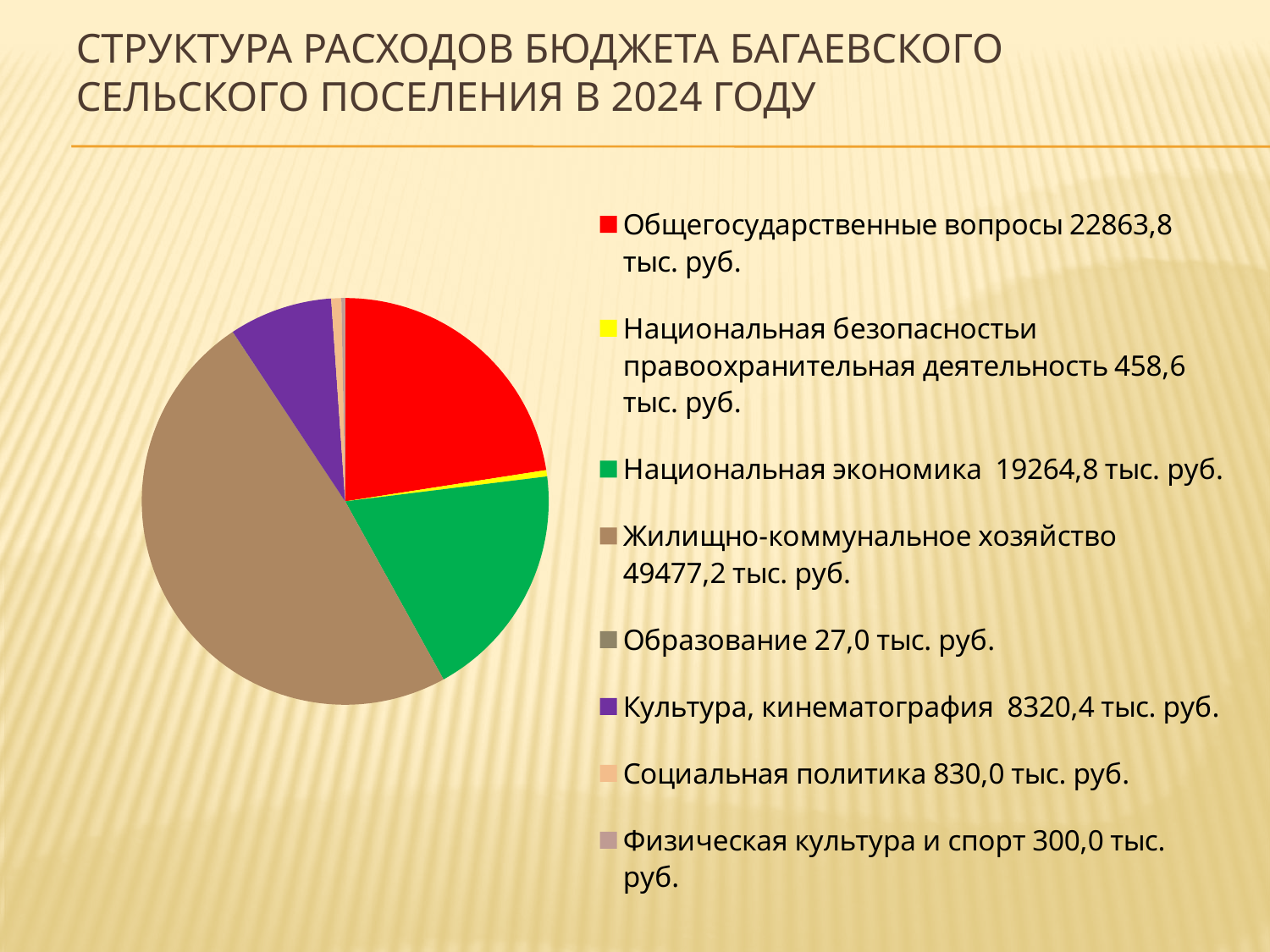
Which category has the largest share of the pie? Жилищно-коммунальное хозяйство What is the difference between Жилищно-коммунальное хозяйство and Общегосударственные вопросы? 26613,4 тыс. руб. Which is larger, Общегосударственные вопросы or Национальная экономика? Общегосударственные вопросы What is the value for Культура, кинематография? 8320,4 тыс. руб. What is the value for Национальная экономика? 19264,8 тыс. руб. Which category has the smallest value? Образование How many categories does the pie chart have? 8 What colour is the slice for Национальная экономика? green What kind of chart is shown on the slide? pie chart What is the value for Социальная политика? 830,0 тыс. руб. How many entries does the legend list? 8 What is the value for Жилищно-коммунальное хозяйство? 49477,2 тыс. руб.